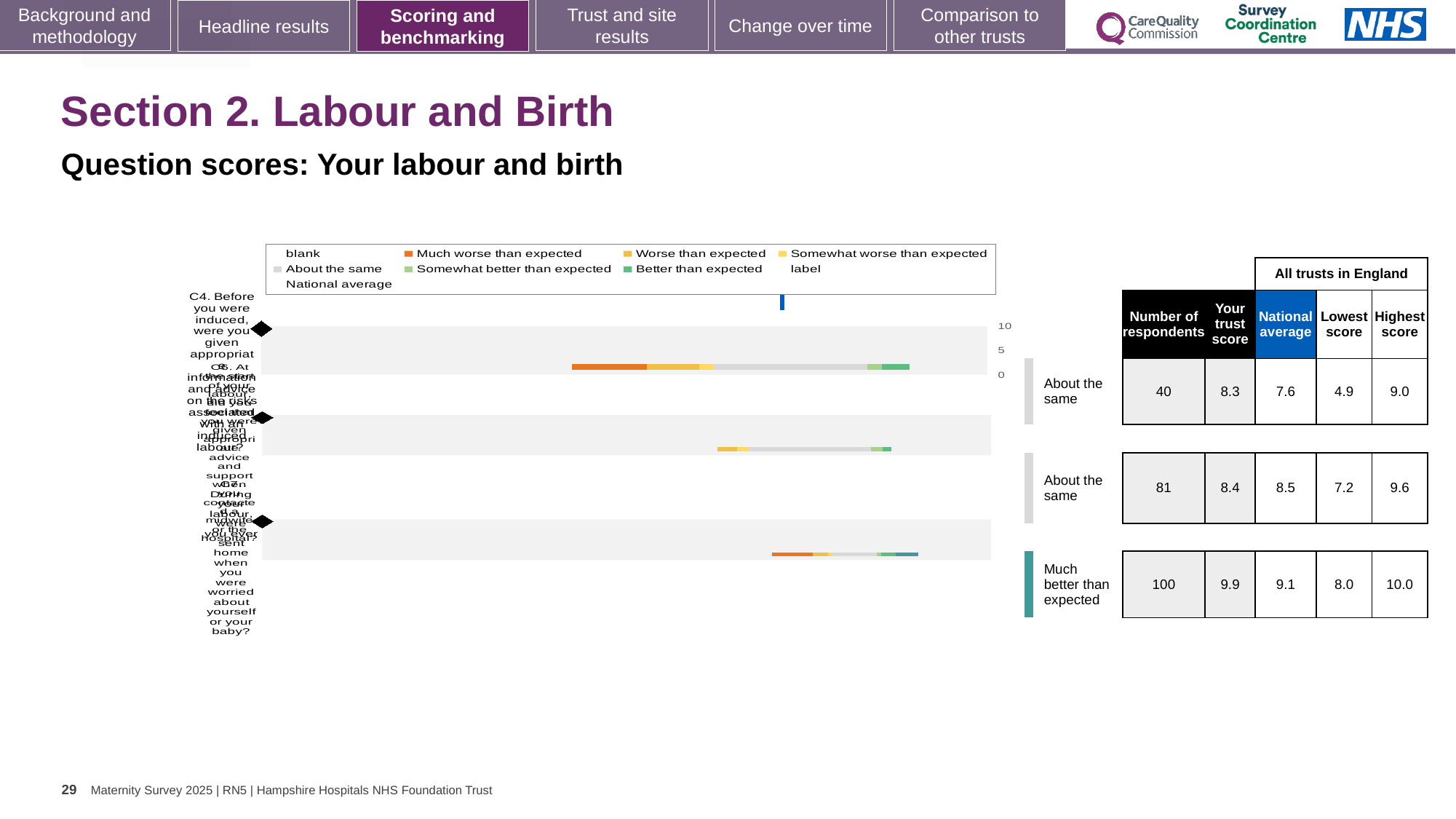
How many question bars are plotted in the chart? 3 In the table beside the chart, which question row has the lowest 'Lowest score'? the first row (4.9) In the table beside the chart, what is the trust score for the third question row? 9.9 In the table beside the chart, which question row has the highest 'Your trust score'? the third row (9.9) In the table beside the chart, what is the national average for the second question row? 8.5 What is the first entry listed in the chart legend? blank What kind of chart is shown on the slide? bar chart What benchmark category is shown for the third question row? Much better than expected In the table beside the chart, what is the difference between the trust score and the national average for the third question row? 0.8 What colour does the legend use for 'Much worse than expected'? orange In the table beside the chart, for the first question row, which is larger: the trust score or the national average? the trust score (8.3) In the table beside the chart, what is the number of respondents for the first question row? 40